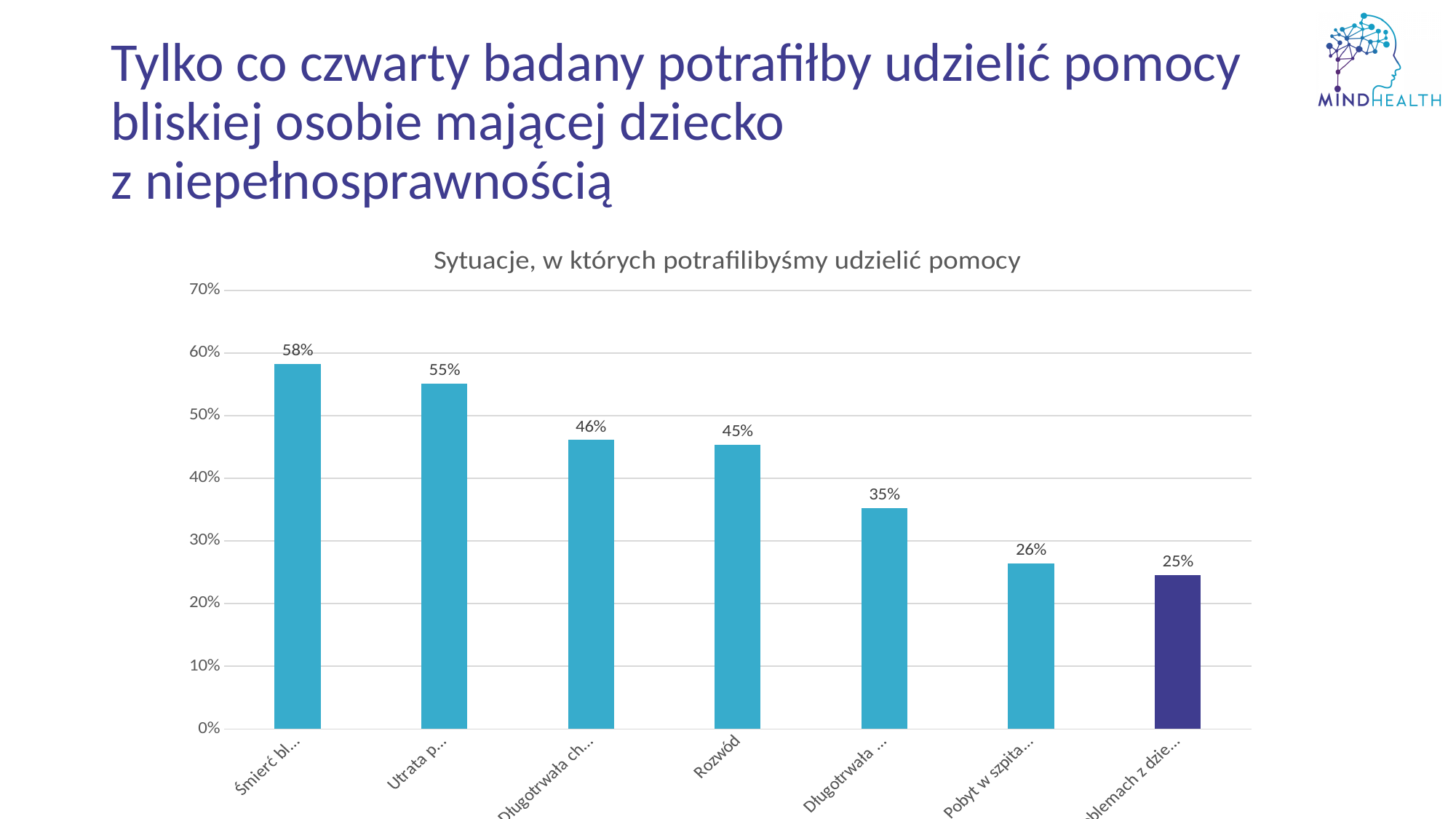
Do the values rise or fall from left to right along the x axis? fall What is the highest value shown in the chart? 58% Which is larger: the value for Rozwód or the value of the second bar from the left? the second bar from the left (55%) How many bars are plotted in the chart? 7 What is the value for Rozwód? 45% What is the difference between the first bar (58%) and the last bar (25%)? 33 percentage points What is the lowest value shown in the chart? 25% What is the value of the first (leftmost) bar in the chart? 58% What is the value of the last (rightmost) bar in the chart? 25% What is the title of the chart? Sytuacje, w których potrafilibyśmy udzielić pomocy What type of chart is shown on the slide? bar chart Which bar is shown in a different (dark purple) colour from the others? the last (rightmost) bar, 25%